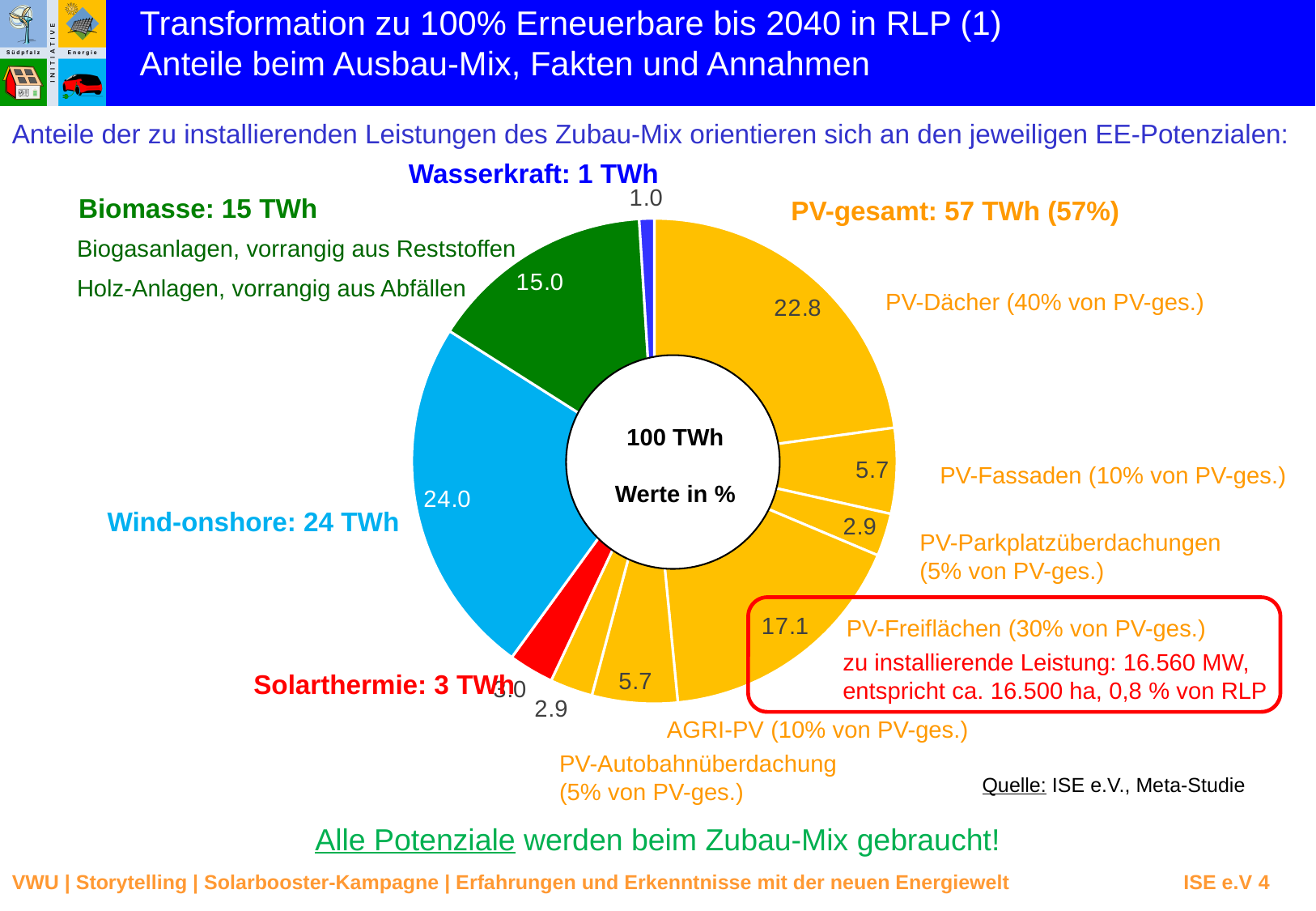
Which slice of the chart has the largest value? Wind-onshore What text is written in the centre of the chart? 100 TWh, Werte in % What is the difference between the Biomasse value and the Solarthermie value? 12.0 Which slice of the chart has the smallest value? Wasserkraft How many slices does the chart have? 10 What value is labelled on the PV-Dächer slice? 22.8 Which is larger, the Biomasse slice or the PV-Freiflächen slice? PV-Freiflächen What kind of chart is shown on the slide? pie chart What is the difference between the PV-Dächer value and the PV-Fassaden value? 17.1 What value is labelled on the PV-Freiflächen slice? 17.1 What value is labelled on the Biomasse slice? 15.0 What percentage value is shown for the Wind-onshore slice? 24.0